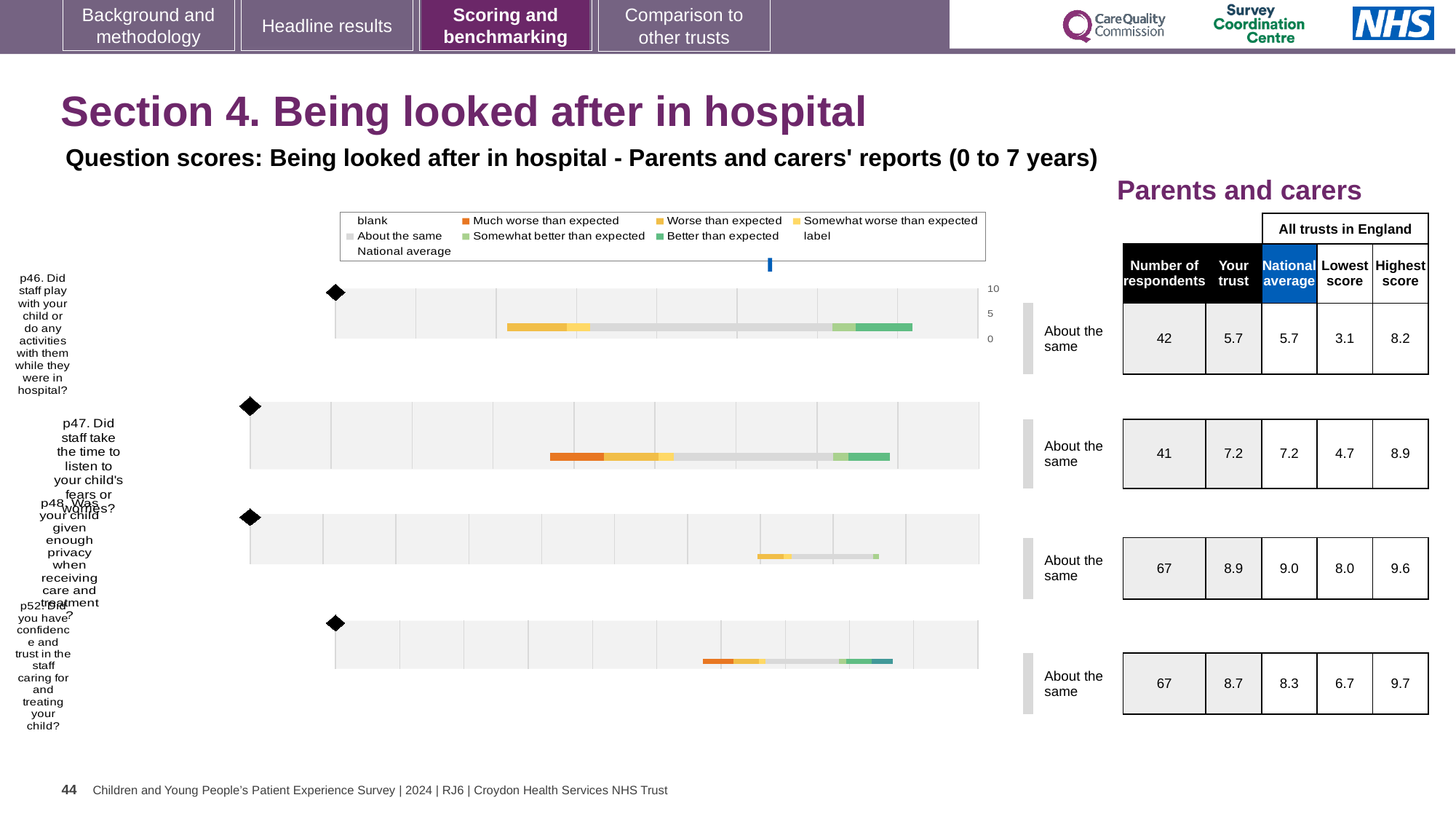
What is the highest score across all trusts in England for p52 (Did you have confidence and trust in the staff caring for and treating your child?)? 9.7 What is the 'Your trust' score for p46 (Did staff play with your child or do any activities with them while they were in hospital?)? 5.7 How many respondents answered p47 (Did staff take the time to listen to your child's fears or worries?)? 41 Which question has the lowest 'Your trust' score on this slide? p46 What benchmark category is shown for p47 (Did staff take the time to listen to your child's fears or worries?)? About the same Which question has the highest 'Your trust' score on this slide? p48 For p52, which is larger: the 'Your trust' score or the national average? Your trust How many survey questions (chart rows) are plotted on this slide? 4 What is the national average score for p48 (Was your child given enough privacy when receiving care and treatment?)? 9.0 In the chart legend, what colour represents 'Much worse than expected'? orange What is the difference between the 'Your trust' score and the national average for p52? 0.4 What kind of chart is used to show the question scores on this slide? bar chart